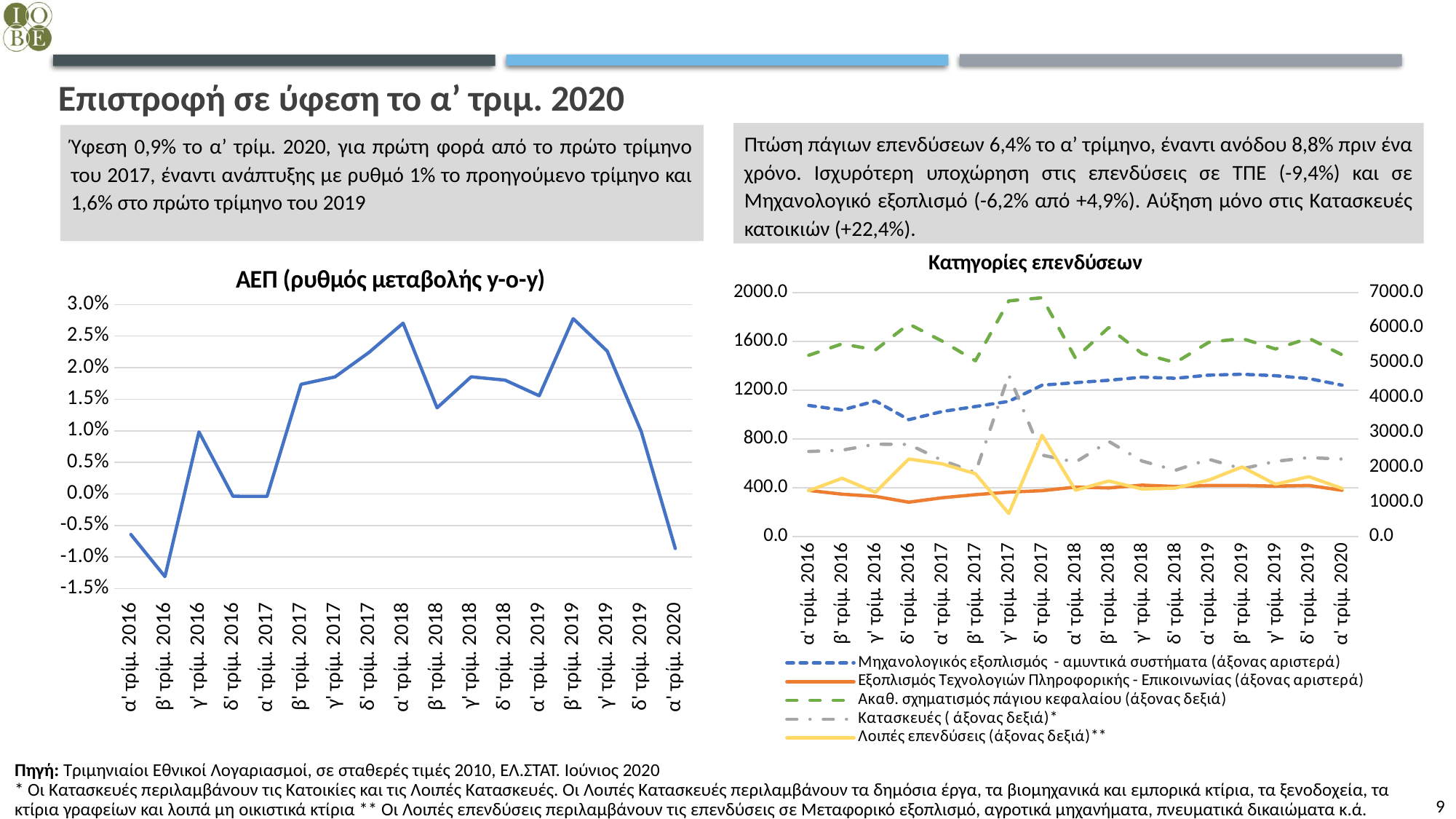
How many series does the legend of the right chart 'Κατηγορίες επενδύσεων' list? 5 In the right chart 'Κατηγορίες επενδύσεων', in which quarter does the series 'Ακαθ. σχηματισμός πάγιου κεφαλαίου (άξονας δεξιά)' reach its highest value? δ' τρίμ. 2017 What kind of chart is the left chart titled 'ΑΕΠ (ρυθμός μεταβολής y-o-y)'? Line chart In the left chart 'ΑΕΠ (ρυθμός μεταβολής y-o-y)', how many quarters are plotted on the x axis? 17 In the right chart 'Κατηγορίες επενδύσεων', which series is drawn as a blue dashed line? Μηχανολογικός εξοπλισμός - αμυντικά συστήματα (άξονας αριστερά) In the left chart 'ΑΕΠ (ρυθμός μεταβολής y-o-y)', which is larger: the value for γ' τρίμ. 2016 or the value for δ' τρίμ. 2016? γ' τρίμ. 2016 In the left chart 'ΑΕΠ (ρυθμός μεταβολής y-o-y)', is the value for β' τρίμ. 2017 greater or less than 1.5%? greater In the left chart 'ΑΕΠ (ρυθμός μεταβολής y-o-y)', which quarter has the lowest value? β' τρίμ. 2016 In the right chart 'Κατηγορίες επενδύσεων', in which quarter does the series 'Λοιπές επενδύσεις (άξονας δεξιά)**' reach its lowest value? γ' τρίμ. 2017 In the left chart 'ΑΕΠ (ρυθμός μεταβολής y-o-y)', do the values rise or fall from β' τρίμ. 2019 to α' τρίμ. 2020? fall In the left chart 'ΑΕΠ (ρυθμός μεταβολής y-o-y)', is the value for α' τρίμ. 2020 greater or less than 0.0%? less In the right chart 'Κατηγορίες επενδύσεων', is the value of 'Εξοπλισμός Τεχνολογιών Πληροφορικής - Επικοινωνίας (άξονας αριστερά)' for δ' τρίμ. 2016 greater or less than 400.0? less